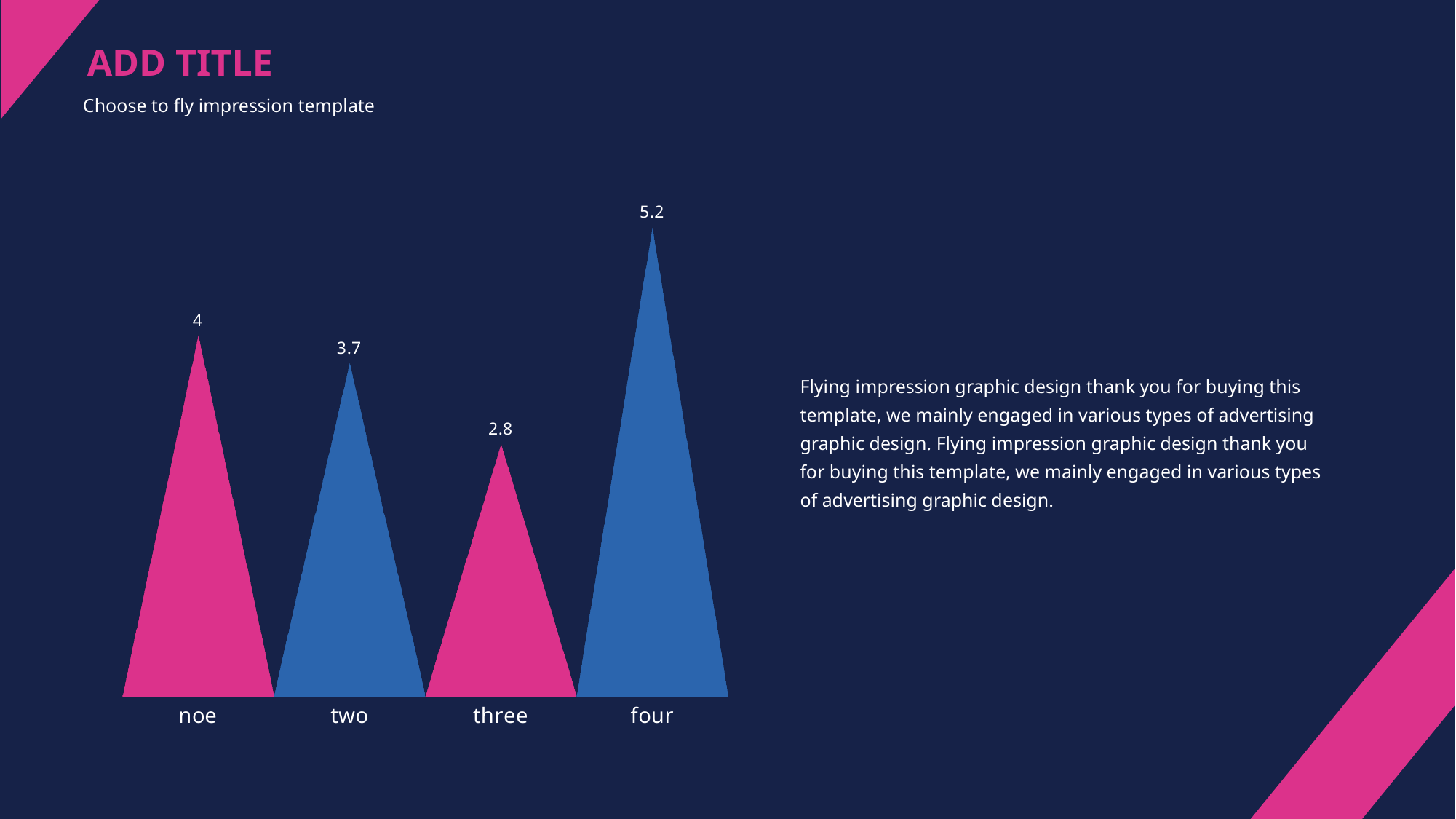
What kind of chart is shown on the slide? bar chart What is the difference between the values for 'four' and 'three'? 2.4 Which is larger, the value for 'noe' or the value for 'two'? noe How many categories are shown on the chart? 4 Which category has the highest value? four What is the value for the category 'three'? 2.8 What is the value for the category 'two'? 3.7 Which category has the lowest value? three What is the value for the category 'noe'? 4 What is the difference between the values for 'noe' and 'two'? 0.3 What colour is the bar for the category 'four'? blue What is the value for the category 'four'? 5.2